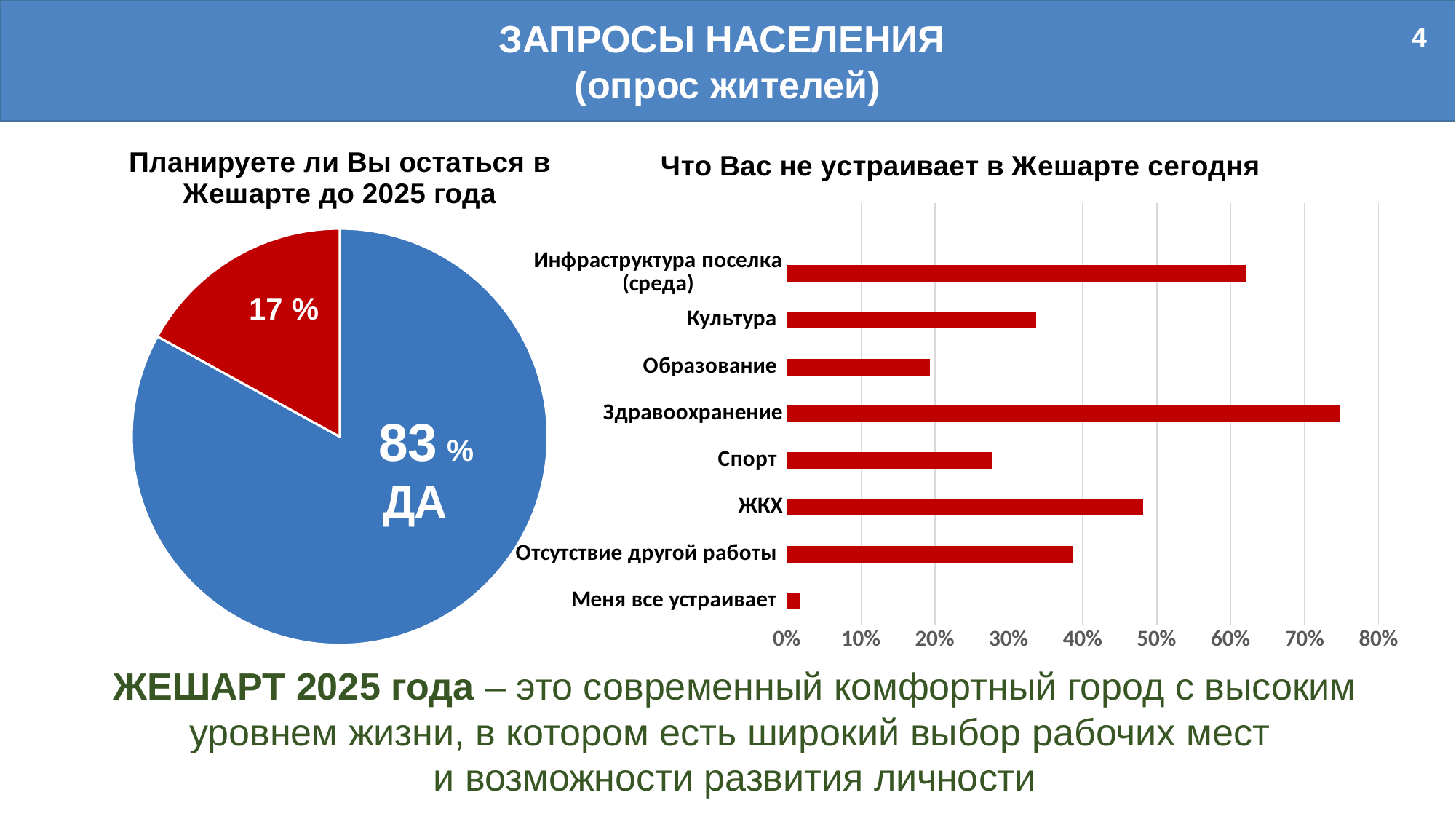
What kind of chart is "Что Вас не устраивает в Жешарте сегодня"? Bar chart What kind of chart is "Планируете ли Вы остаться в Жешарте до 2025 года"? Pie chart In the chart "Что Вас не устраивает в Жешарте сегодня", is the value for Здравоохранение greater or less than 70%? greater In the chart "Что Вас не устраивает в Жешарте сегодня", is the value for Инфраструктура поселка (среда) greater or less than 60%? greater How many categories are shown in the chart "Что Вас не устраивает в Жешарте сегодня"? 8 In the chart "Что Вас не устраивает в Жешарте сегодня", which category has the lowest value? Меня все устраивает In the pie chart "Планируете ли Вы остаться в Жешарте до 2025 года", what share of respondents answered ДА? 83 % In the pie chart "Планируете ли Вы остаться в Жешарте до 2025 года", what is the value of the red slice? 17 % In the chart "Что Вас не устраивает в Жешарте сегодня", which is larger: Спорт or Отсутствие другой работы? Отсутствие другой работы In the chart "Что Вас не устраивает в Жешарте сегодня", which is larger: ЖКХ or Культура? ЖКХ In the chart "Что Вас не устраивает в Жешарте сегодня", which category has the highest value? Здравоохранение